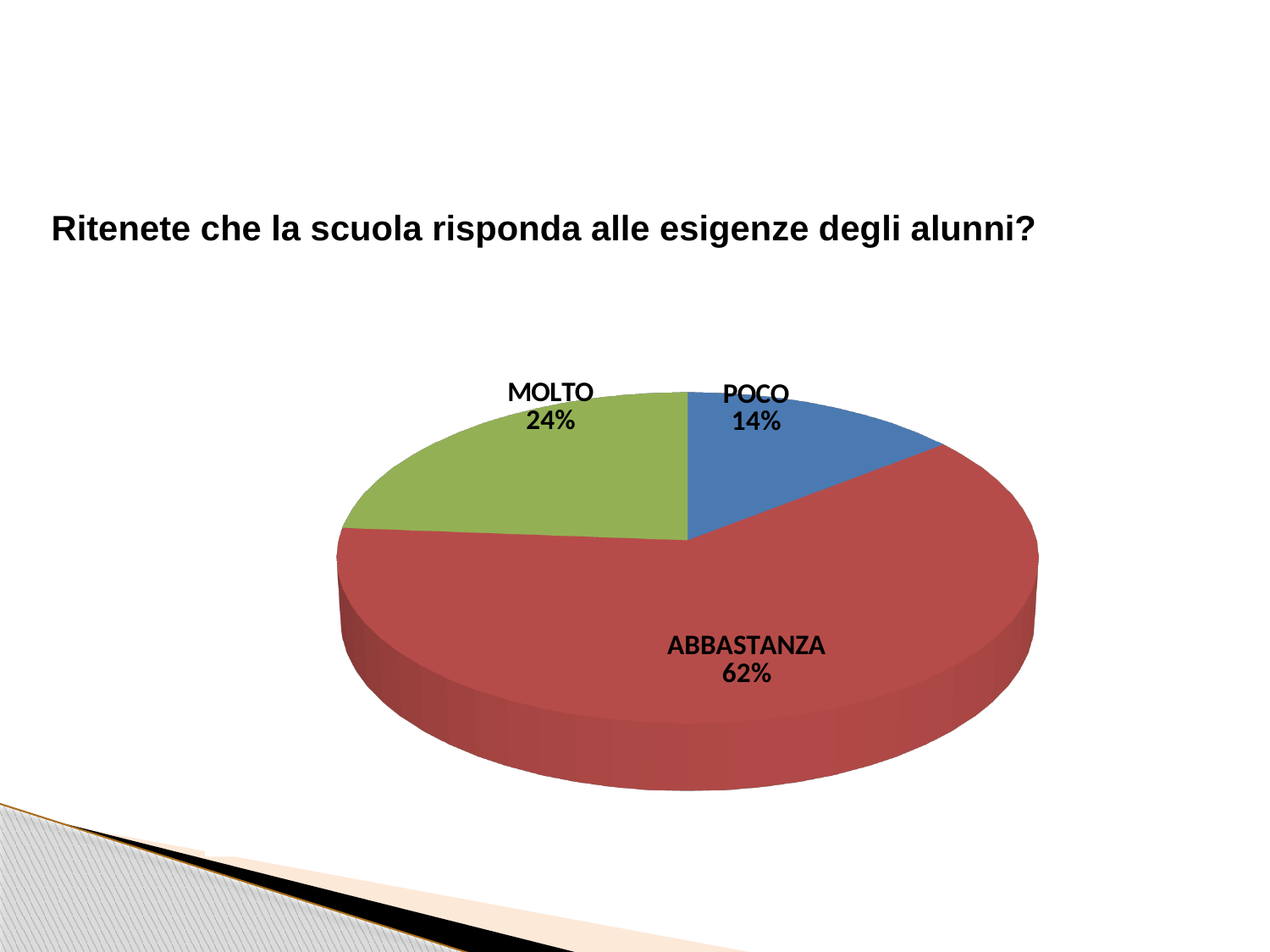
Which category has the smallest slice of the pie? POCO What kind of chart is shown on the slide? Pie chart What colour is the ABBASTANZA slice? Red What question is the chart answering, as shown in the slide title? Ritenete che la scuola risponda alle esigenze degli alunni? Which is larger, the MOLTO slice or the POCO slice? MOLTO How many categories are shown in the pie chart? 3 What is the difference in percentage points between ABBASTANZA and MOLTO? 38 What share of the pie does POCO represent? 14% Which category has the largest slice of the pie? ABBASTANZA What share of the pie does MOLTO represent? 24% What share of the pie does ABBASTANZA represent? 62% What is the difference in percentage points between MOLTO and POCO? 10